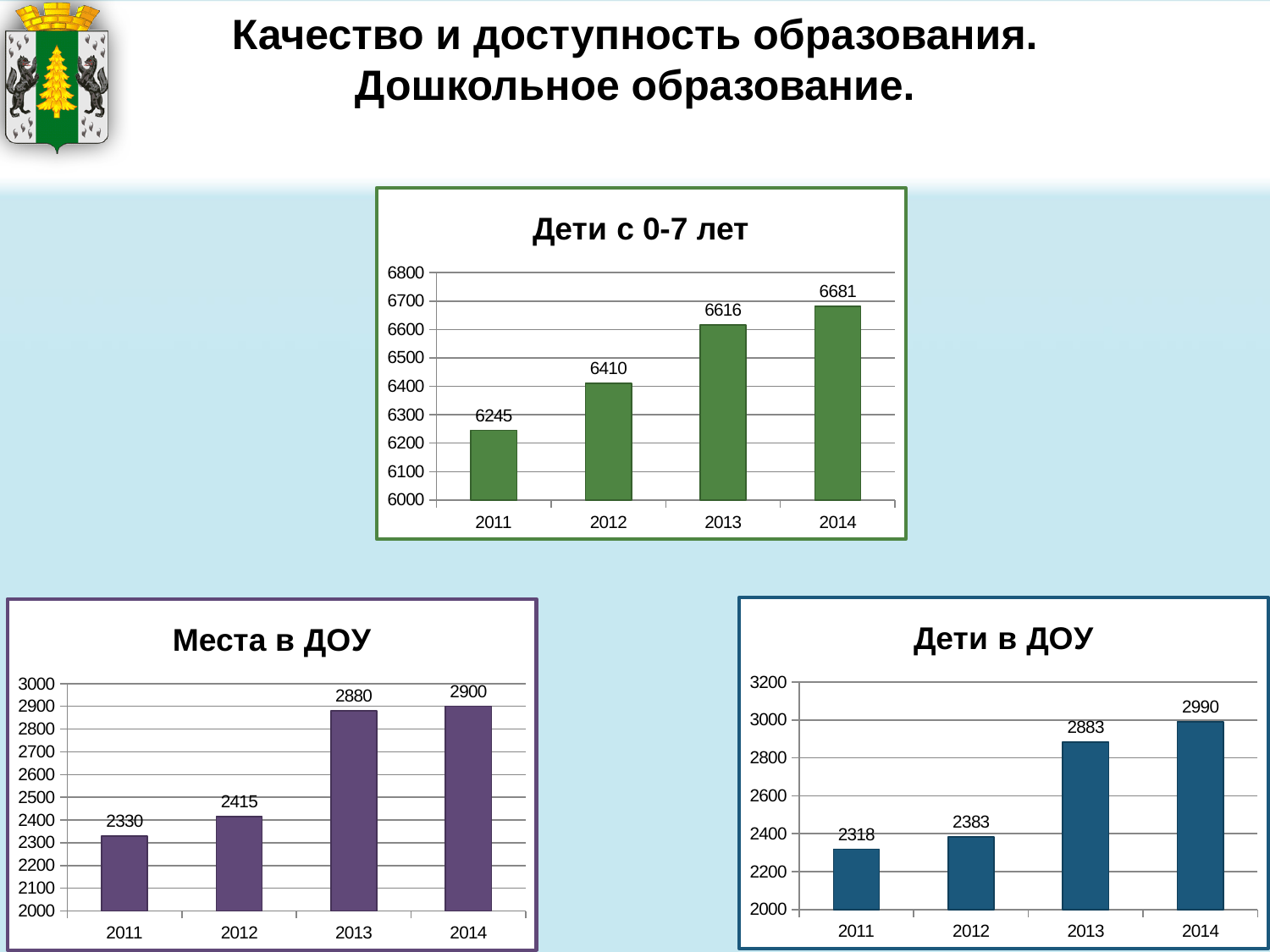
In the chart titled "Дети в ДОУ", which is larger, the value for 2012 or the value for 2013? 2013 In the chart titled "Места в ДОУ", what is the difference between the values for 2013 and 2012? 465 What kind of chart is the chart titled "Дети в ДОУ"? bar chart In the chart titled "Дети в ДОУ", how many years are shown on the x axis? 4 How many charts are shown on the slide? 3 In the chart titled "Места в ДОУ", which year has the lowest value? 2011 In the chart titled "Дети в ДОУ", what is the value for 2011? 2318 In the chart titled "Дети с 0-7 лет", which year has the highest value? 2014 In the chart titled "Дети с 0-7 лет", do the values rise or fall from 2011 to 2014? rise In the chart titled "Дети с 0-7 лет", what is the value for 2012? 6410 In the chart titled "Дети с 0-7 лет", what is the difference between the values for 2014 and 2011? 436 In the chart titled "Места в ДОУ", what is the value for 2013? 2880